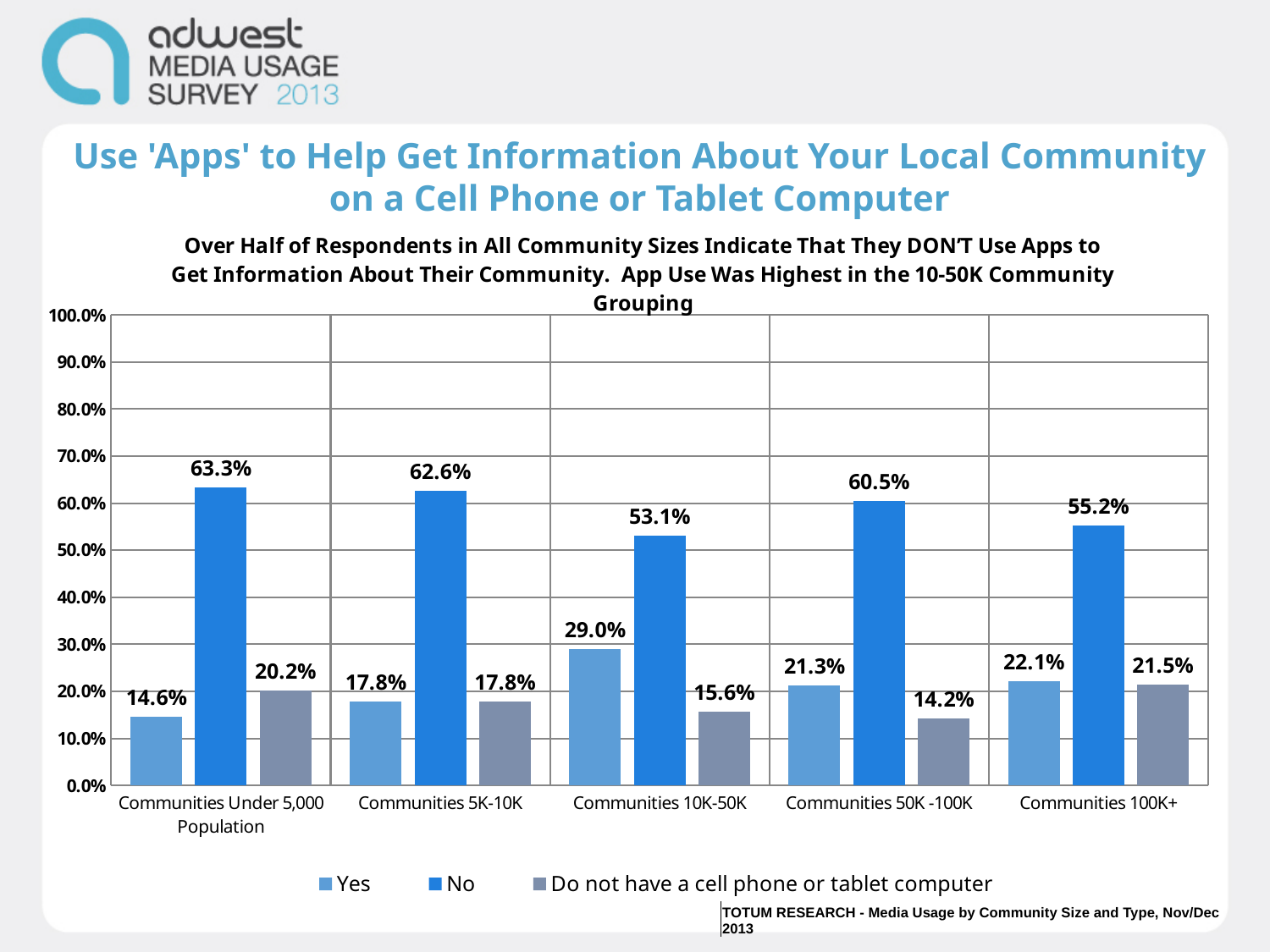
Which community size has the lowest Yes value? Communities Under 5,000 Population What is the No value for Communities 50K -100K? 60.5% How many series does the legend list? 3 What percentage of respondents in Communities 10K-50K answered Yes? 29.0% Which series is shown in the darkest blue colour? No What percentage of respondents in Communities 100K+ do not have a cell phone or tablet computer? 21.5% Which community size has the highest No value? Communities Under 5,000 Population Which is larger for Communities 10K-50K: the Yes value or the 'Do not have a cell phone or tablet computer' value? Yes What kind of chart is shown on the slide? Bar chart How many community size categories are shown on the x axis? 5 Is the No value for Communities 100K+ greater or less than 50.0%? greater What is the difference between the No and Yes values for Communities 5K-10K? 44.8%